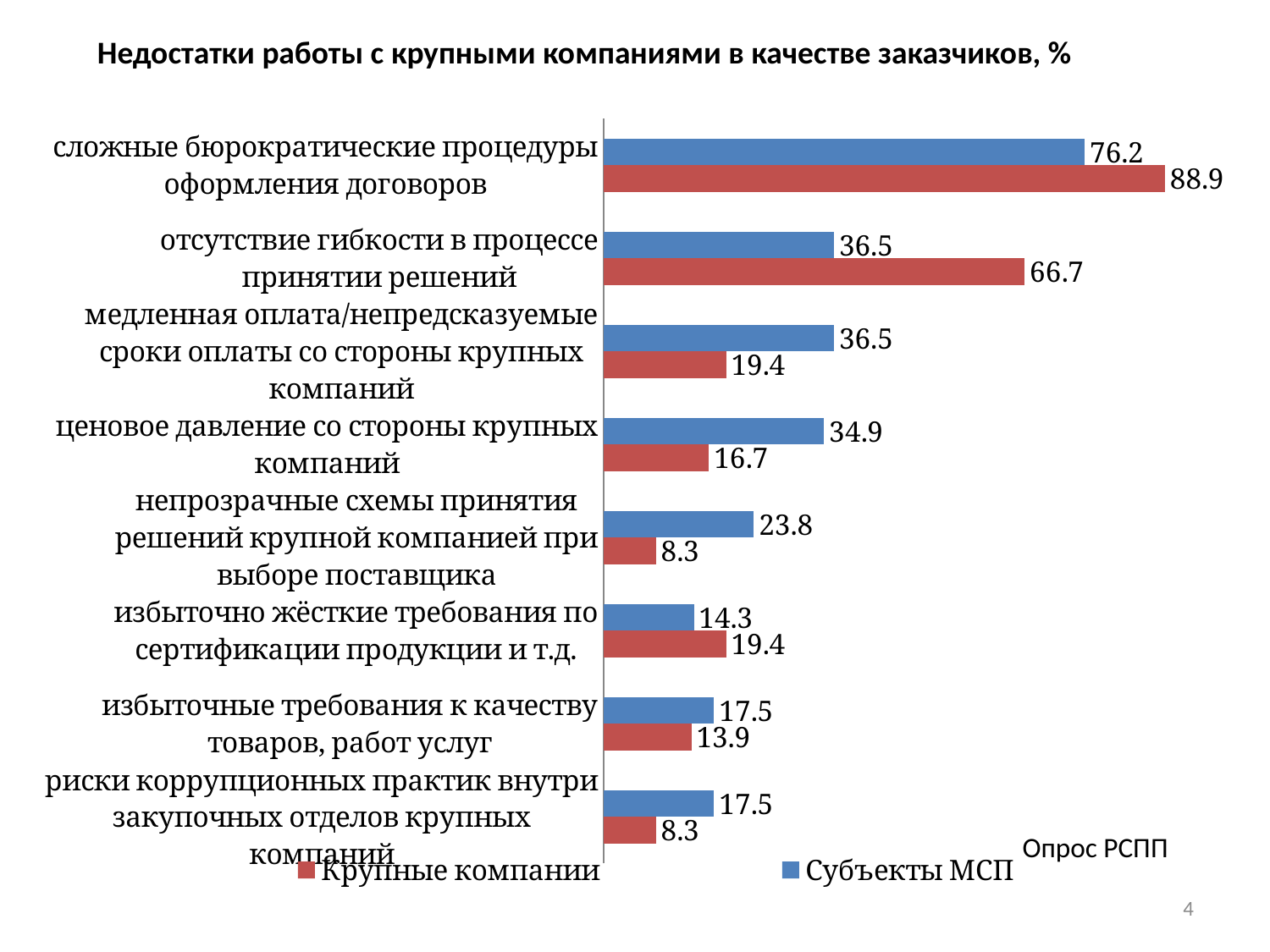
What is the value for 'Субъекты МСП' for 'ценовое давление со стороны крупных компаний'? 34.9 What is the value for 'Крупные компании' for 'избыточно жёсткие требования по сертификации продукции и т.д.'? 19.4 How many series does the legend list? 2 What is the difference between 'Крупные компании' and 'Субъекты МСП' for 'отсутствие гибкости в процессе принятии решений'? 30.2 What is the title of the chart? Недостатки работы с крупными компаниями в качестве заказчиков, % Which category has the lowest value for 'Субъекты МСП'? избыточно жёсткие требования по сертификации продукции и т.д. Which category has the highest value for 'Субъекты МСП'? сложные бюрократические процедуры оформления договоров For 'медленная оплата/непредсказуемые сроки оплаты со стороны крупных компаний', which series has the larger value: 'Крупные компании' or 'Субъекты МСП'? Субъекты МСП What is the difference between 'Субъекты МСП' and 'Крупные компании' for 'непрозрачные схемы принятия решений крупной компанией при выборе поставщика'? 15.5 What is the value for 'Крупные компании' for 'сложные бюрократические процедуры оформления договоров'? 88.9 How many categories are shown in the chart? 8 What type of chart is shown on the slide? bar chart